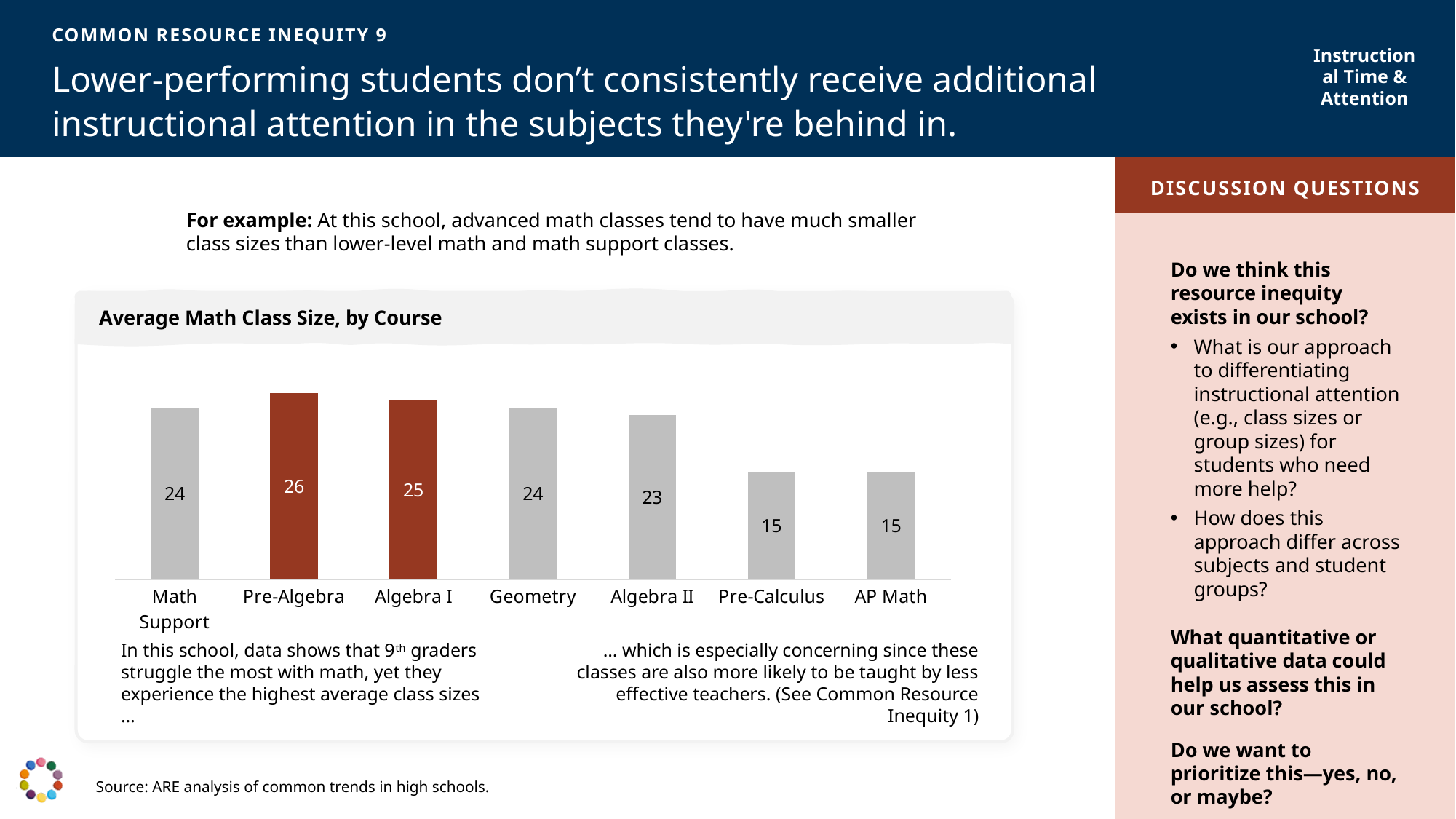
Which has a larger average class size, Geometry or AP Math? Geometry What is the difference in average class size between Pre-Algebra and Pre-Calculus? 11 What is the average class size for Algebra II? 23 What is the average class size for AP Math? 15 What kind of chart is used to show average math class size by course? Bar chart What is the title of the chart? Average Math Class Size, by Course Which course has the highest average class size? Pre-Algebra Which has a larger average class size, Math Support or Pre-Calculus? Math Support What is the difference in average class size between Algebra I and Algebra II? 2 What is the average class size for Pre-Algebra? 26 How many courses are shown in the chart? 7 Which two courses' bars are highlighted in red? Pre-Algebra and Algebra I